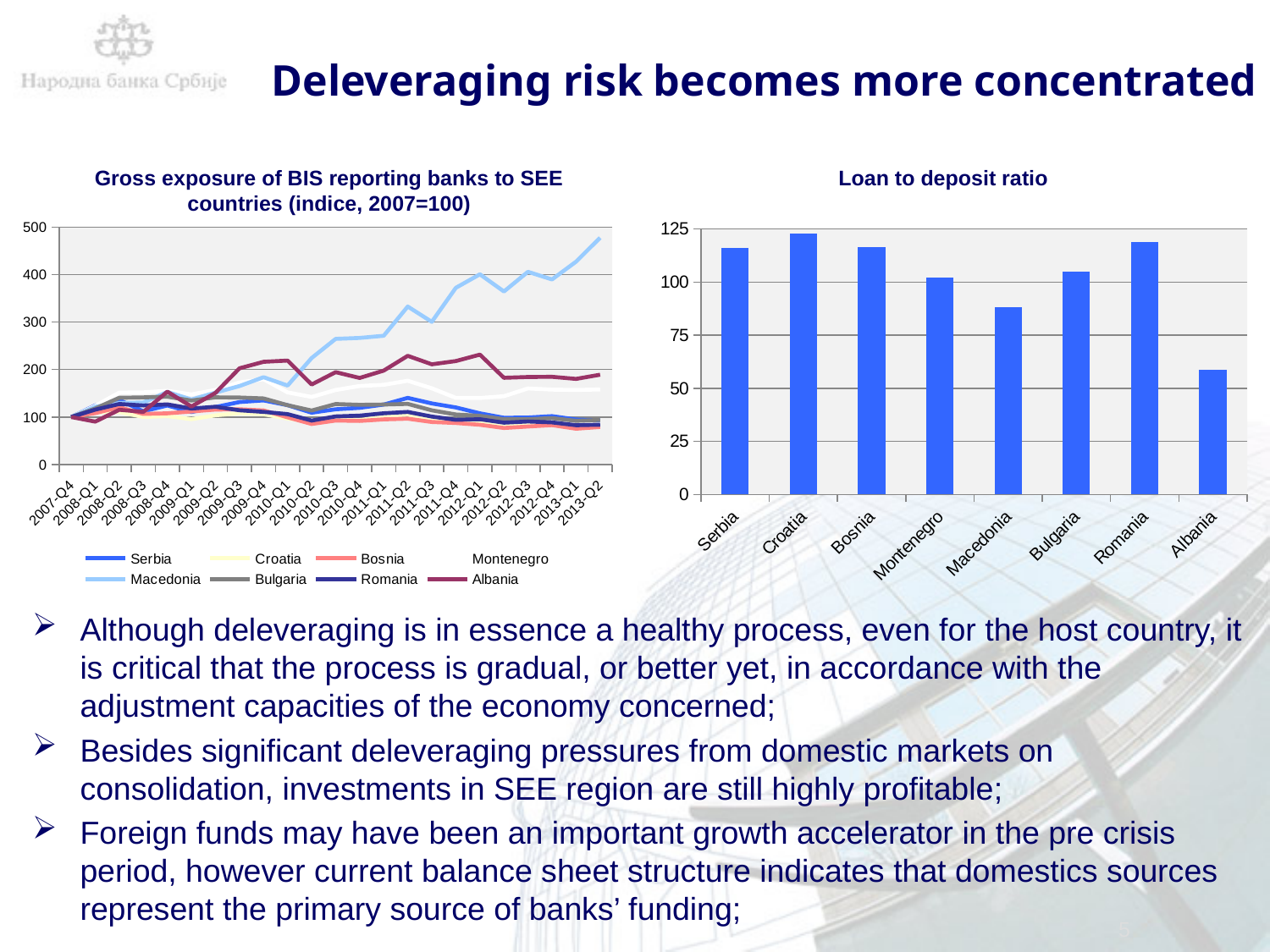
How many series does the legend of the 'Gross exposure of BIS reporting banks to SEE countries' chart list? 8 In the 'Gross exposure of BIS reporting banks to SEE countries' chart, does the Macedonia series rise or fall from 2007-Q4 to 2013-Q2? rise In the 'Loan to deposit ratio' chart, is the value for Macedonia greater or less than 100? less In the 'Loan to deposit ratio' chart, which country has the highest loan to deposit ratio? Croatia What type of chart is the 'Gross exposure of BIS reporting banks to SEE countries' chart? line chart In the 'Loan to deposit ratio' chart, is the value for Romania greater or less than 100? greater In the 'Loan to deposit ratio' chart, is the value for Albania greater or less than 75? less What type of chart is the 'Loan to deposit ratio' chart? bar chart In the 'Loan to deposit ratio' chart, which country has the lowest loan to deposit ratio? Albania In the 'Loan to deposit ratio' chart, which is larger, the value for Serbia or the value for Macedonia? Serbia In the 'Gross exposure of BIS reporting banks to SEE countries' chart, which series has the highest value at 2013-Q2? Macedonia How many countries are shown in the 'Loan to deposit ratio' chart? 8